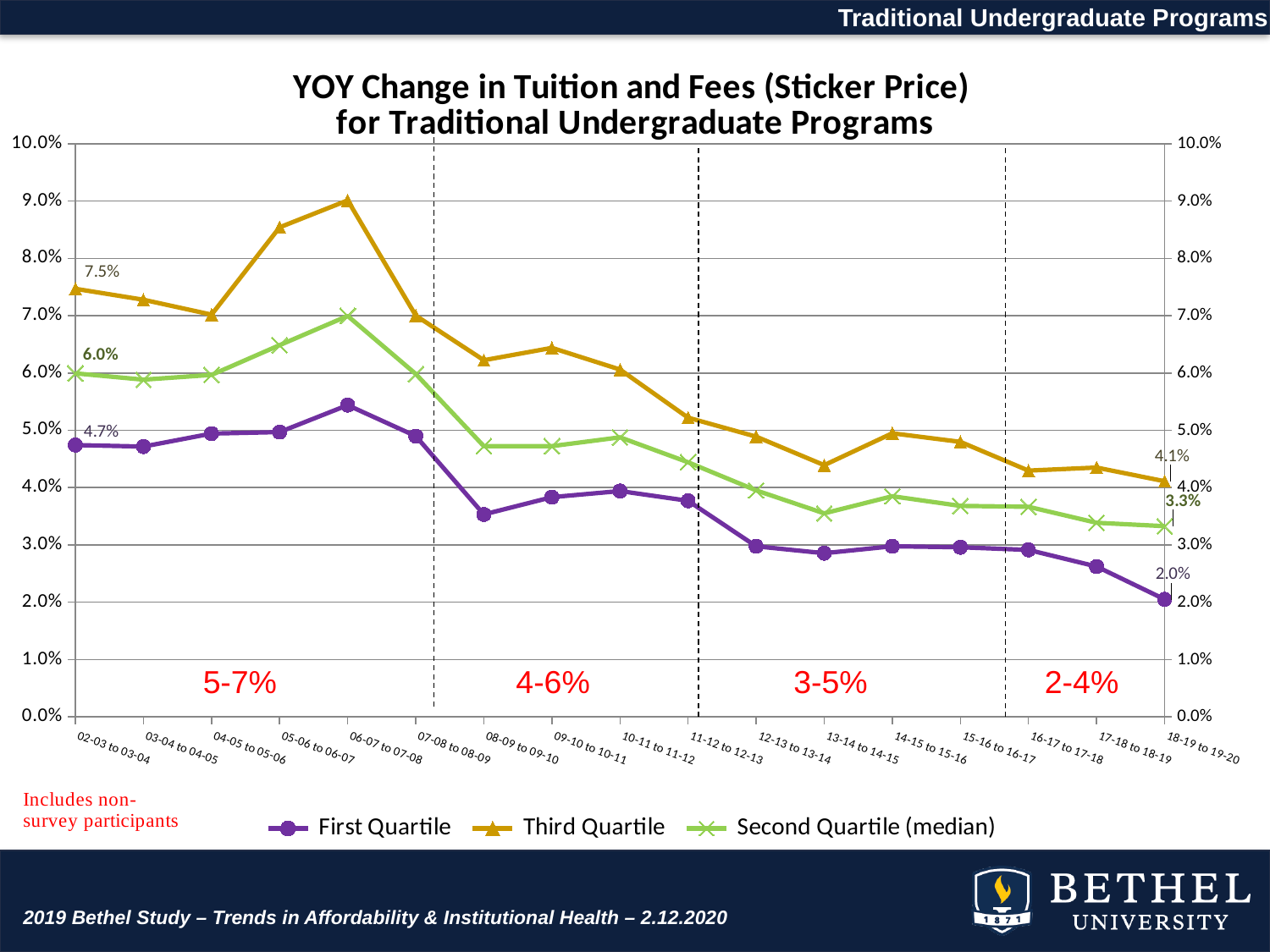
What is the First Quartile value for 18-19 to 19-20? 2.0% How many series does the legend list? 3 What is the Second Quartile (median) value for 02-03 to 03-04? 6.0% Is the First Quartile value for 08-09 to 09-10 greater or less than 4.0%? less What is the Third Quartile value for 18-19 to 19-20? 4.1% What kind of chart is shown on the slide? Line chart By how many percentage points did the Third Quartile value fall from 02-03 to 03-04 to 18-19 to 19-20? 3.4 percentage points In which period does the Third Quartile reach its highest value? 06-07 to 07-08 Does the Third Quartile line generally rise or fall from left to right across the periods? Fall Is the Third Quartile value for 06-07 to 07-08 greater or less than 8.0%? greater What is the Third Quartile value for 02-03 to 03-04? 7.5% What is the difference between the First Quartile value for 02-03 to 03-04 and for 18-19 to 19-20? 2.7 percentage points